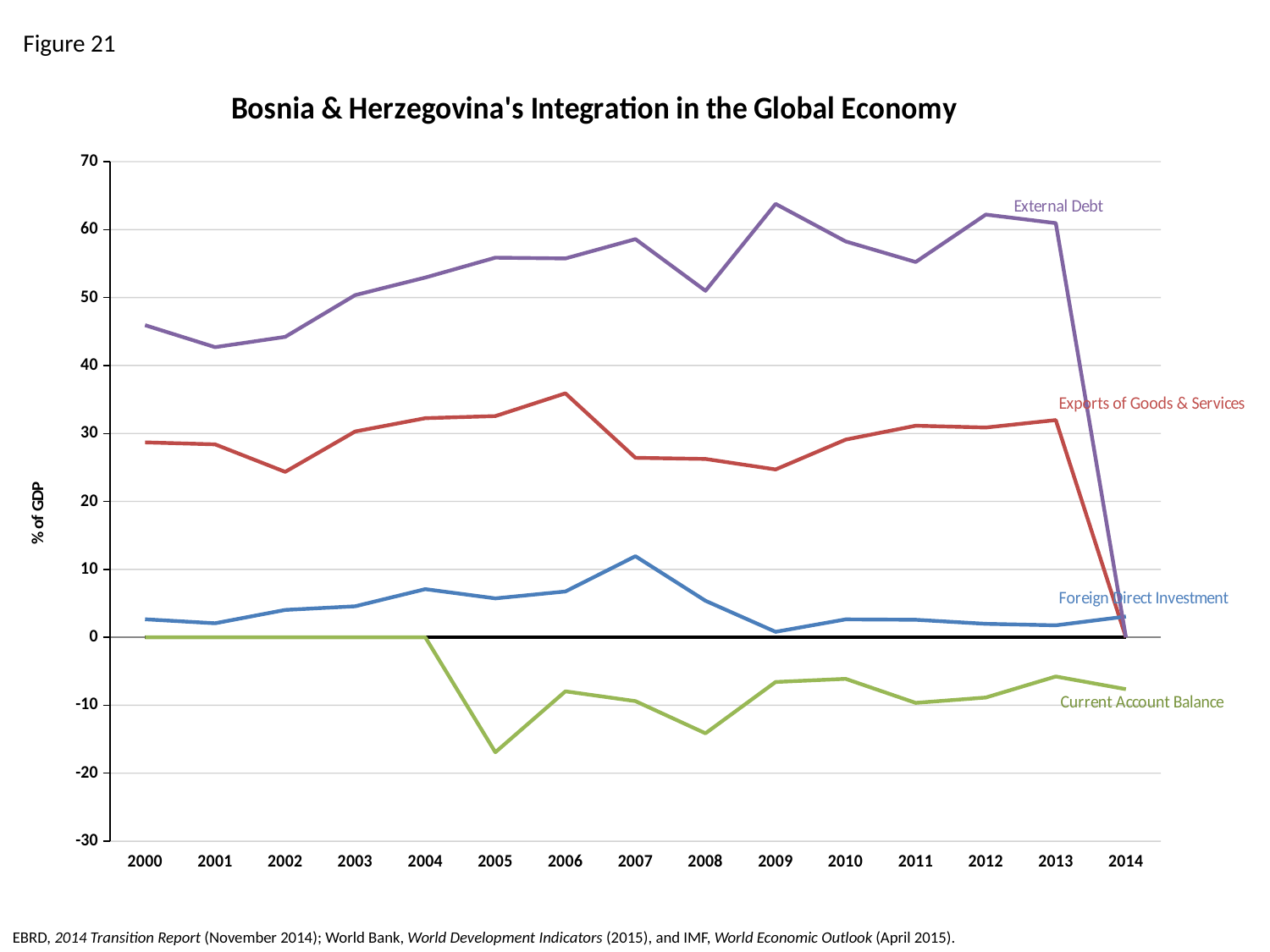
Is the value for Foreign Direct Investment in 2007 greater or less than 10? greater How many years are shown along the x axis? 15 In which year do Exports of Goods & Services reach their highest value? 2006 Is the value for Current Account Balance in 2005 greater or less than -10? less Is the value for Exports of Goods & Services in 2006 greater or less than 30? greater How many series are plotted on the chart? 4 In 2010, which is larger: External Debt or Exports of Goods & Services? External Debt What kind of chart is shown on the slide? line chart In which year does Foreign Direct Investment reach its highest value? 2007 In which year does Current Account Balance reach its lowest value? 2005 What is the label on the y axis? % of GDP